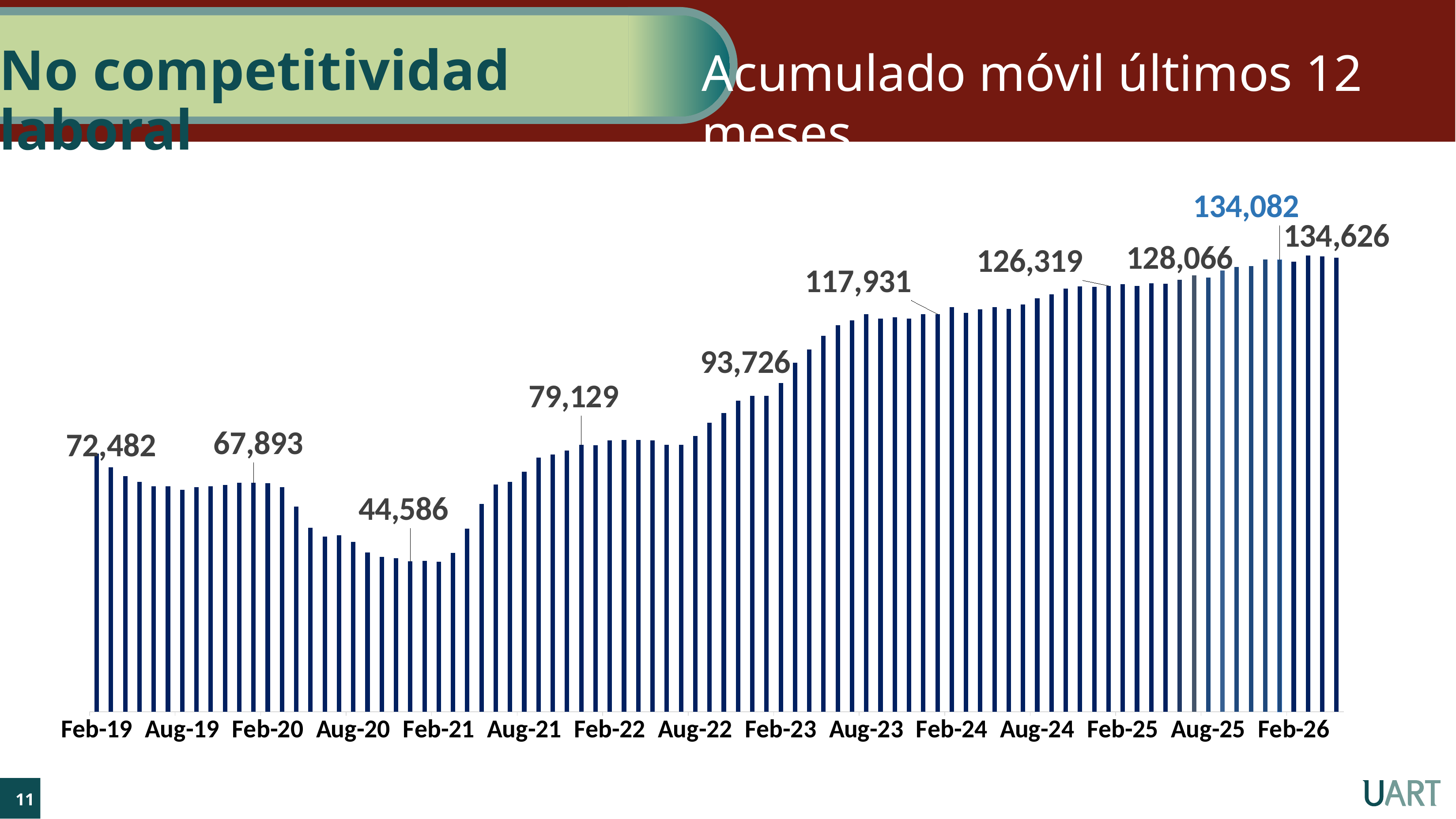
Do the bars generally rise or fall from Feb-21 to Feb-26? rise How many date labels are shown on the x axis? 15 What is the lowest value labelled on the chart? 44,586 What is the highest value labelled on the chart? 134,626 What is the value labelled on the last bar of the chart? 134,626 Which data label is shown in blue rather than grey? 134,082 What is the value of the first bar, for Feb-19? 72,482 What is the difference between the labels 134,626 and 134,082? 544 What is the difference between the last labelled value (134,626) and the Feb-19 value (72,482)? 62,144 Which is larger, the bar for Feb-19 or the bar for Feb-21? Feb-19 What type of chart is shown on the slide? bar chart Which is larger, the bar for Aug-20 or the bar for Aug-23? Aug-23